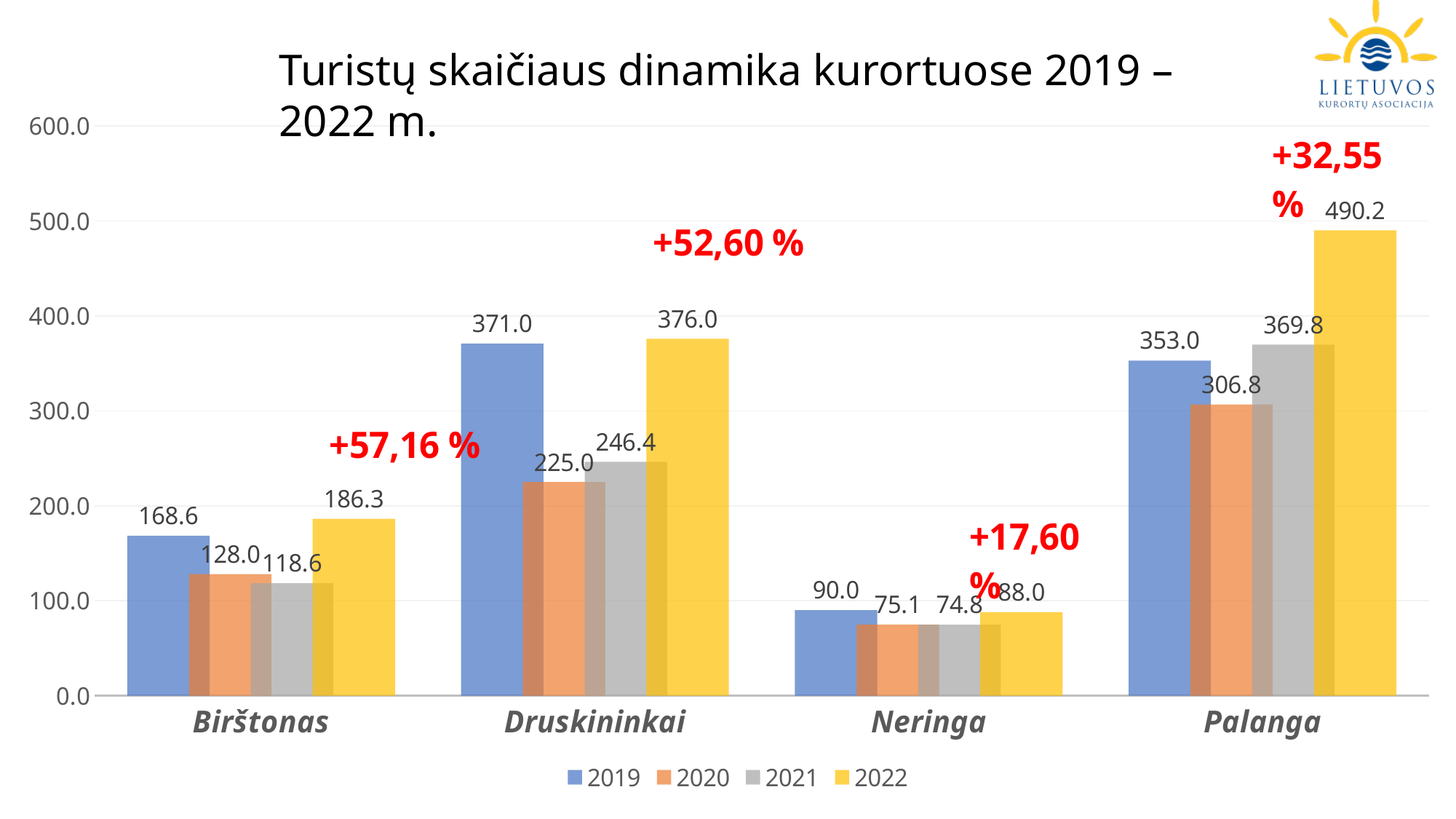
What percentage change is annotated in red above the Druskininkai group? +52,60 % What is the value for Druskininkai in 2020? 225.0 How many resorts are shown on the x axis? 4 Which colour represents the 2022 series in the legend? Yellow Which resort has the highest value in 2022? Palanga Which is larger for Druskininkai: the 2021 value or the 2020 value? 2021 What is the value for Palanga in 2022? 490.2 What is the value for Birštonas in 2019? 168.6 What kind of chart is shown on the slide? Bar chart How many series does the legend list? 4 What is the difference between the 2022 and 2019 values for Palanga? 137.2 Which resort has the lowest value in 2021? Neringa